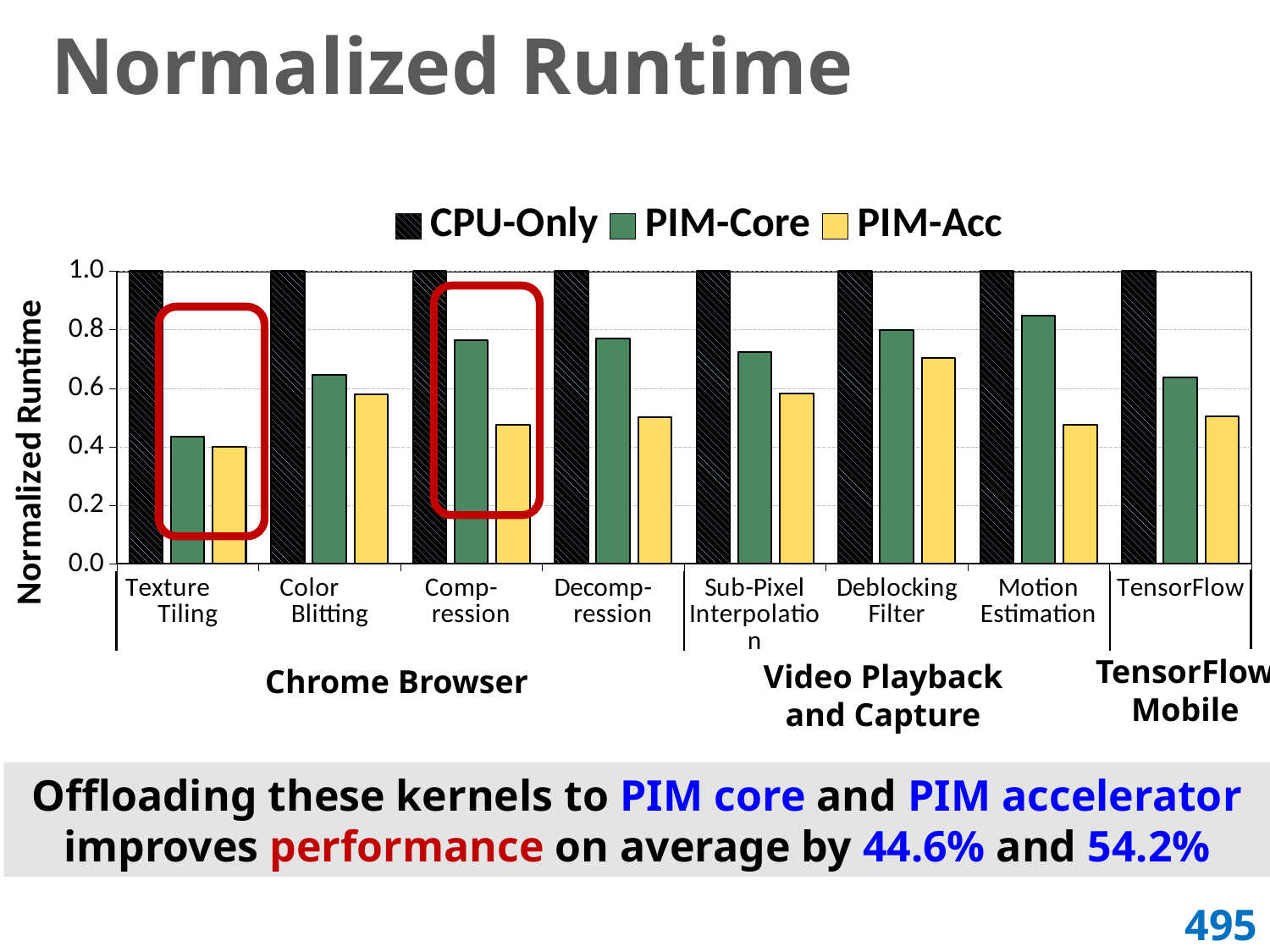
What kind of chart is shown on the slide? bar chart Is the PIM-Acc value for Color Blitting greater or less than 0.4? greater What is the title of the chart? Normalized Runtime How many series does the legend list? 3 What is the CPU-Only normalized runtime for Texture Tiling? 1.0 Is the PIM-Core value for Motion Estimation greater or less than 0.6? greater How many kernel categories are plotted along the x axis? 8 Is the PIM-Acc value for Deblocking Filter greater or less than 0.6? greater For Compression, which is larger: the PIM-Core value or the PIM-Acc value? PIM-Core Which kernel has the lowest PIM-Acc normalized runtime? Texture Tiling What colour represents the PIM-Acc series in the legend? yellow